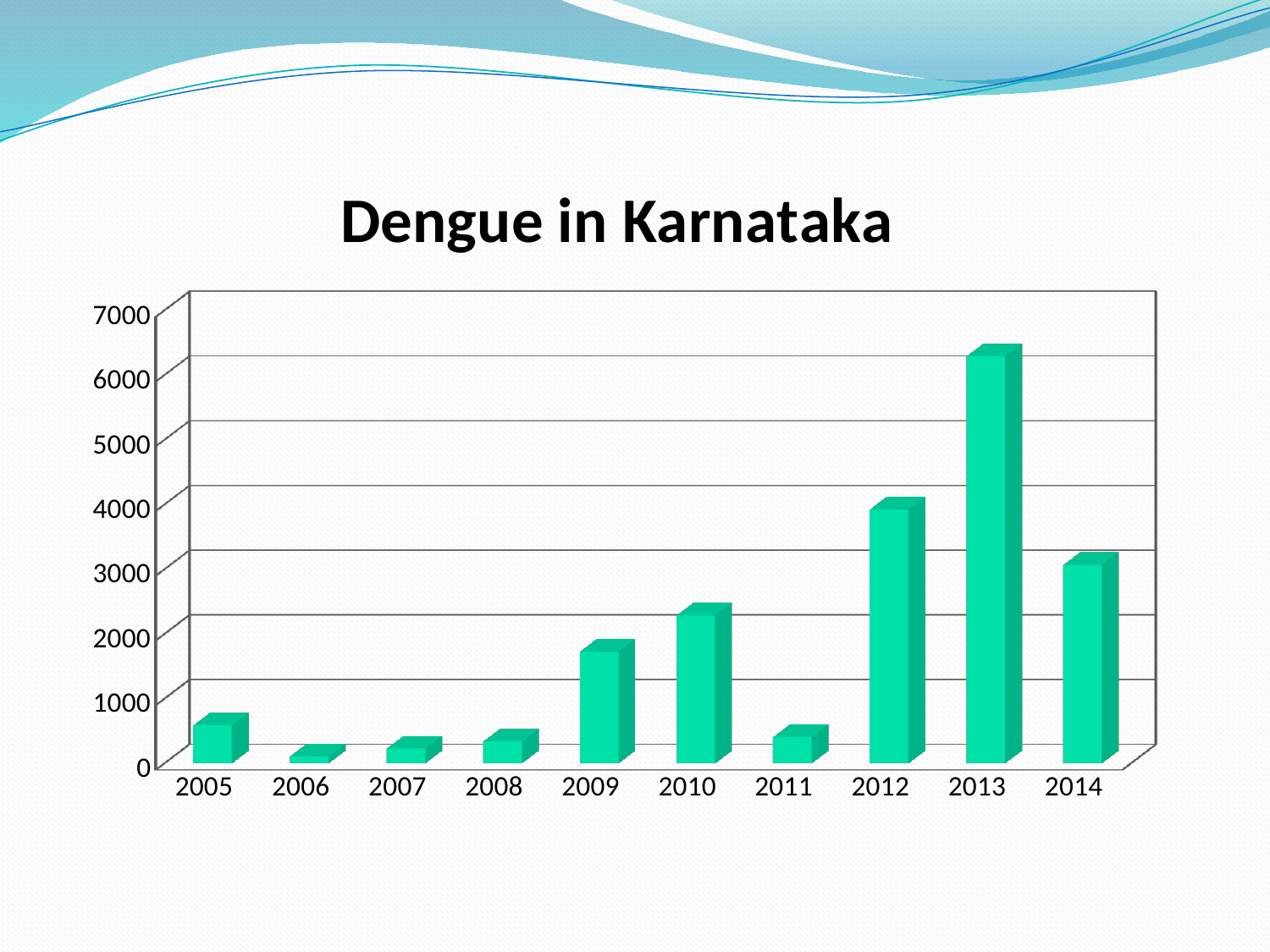
Is the value for 2014 greater or less than 4000? less Which year has the lowest value in the chart? 2006 Do the values rise or fall from 2011 to 2013? rise Is the value for 2009 greater or less than 2000? less Which year has the larger value, 2009 or 2010? 2010 What kind of chart is shown on the slide? bar chart Which year has the larger value, 2012 or 2014? 2012 How many years are shown on the x axis of the chart? 10 Is the value for 2010 greater or less than 2000? greater Which year has the highest value in the chart? 2013 What is the title of the chart? Dengue in Karnataka